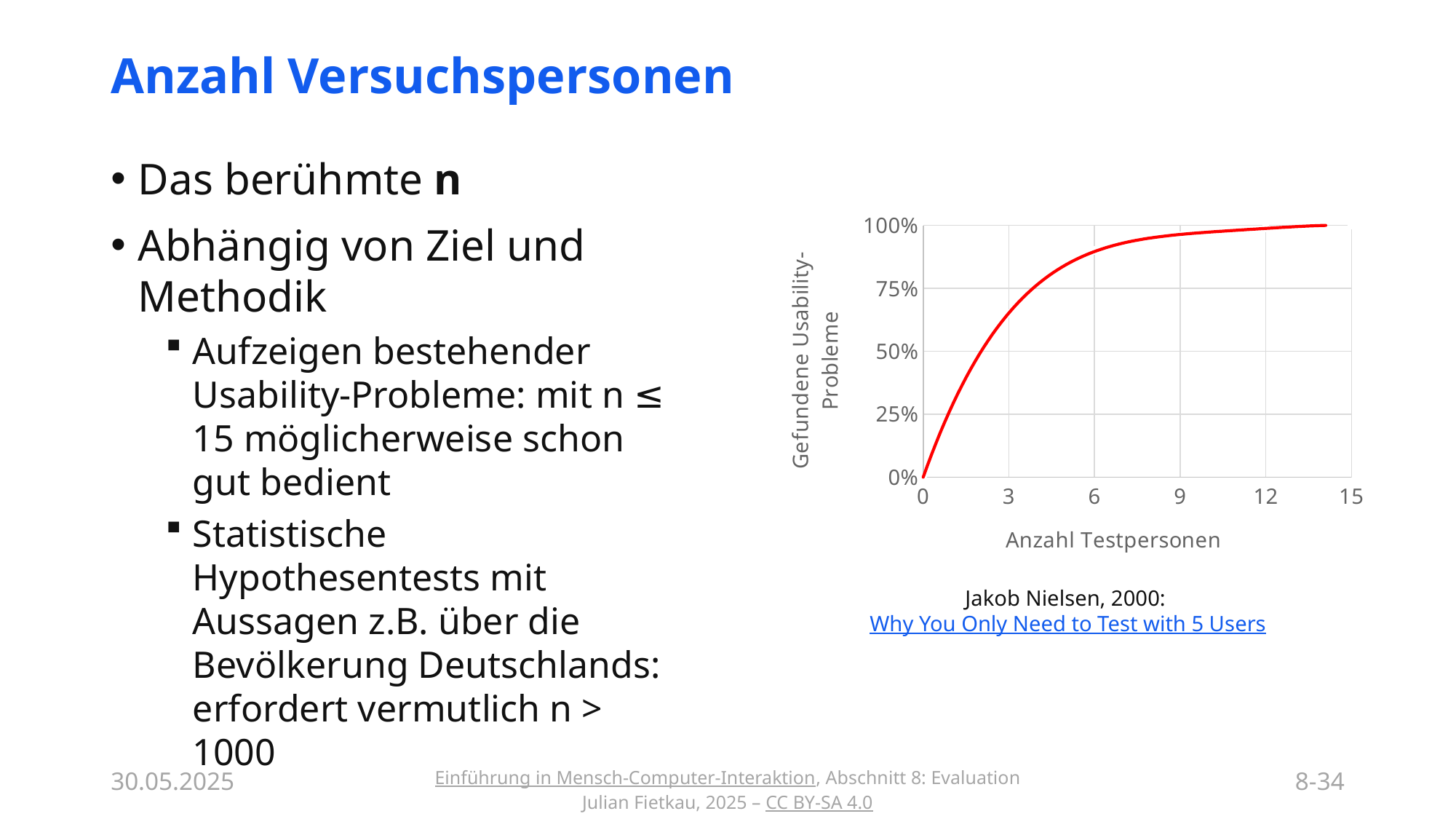
What kind of chart is shown on the slide? line chart What is the highest value shown on the y axis of the chart? 100% What is the label of the y axis of the chart? Gefundene Usability-Probleme Is the value of the curve at 3 test persons greater or less than 50%? greater Is the value of the curve at 12 test persons greater or less than 75%? greater Is the value of the curve at 6 test persons greater or less than 75%? greater What is the value of the curve at 0 test persons? 0% Which is larger: the value of the curve at 3 test persons or at 9 test persons? 9 test persons Do the values of the curve rise or fall as the number of test persons increases? rise What is the label of the x axis of the chart? Anzahl Testpersonen